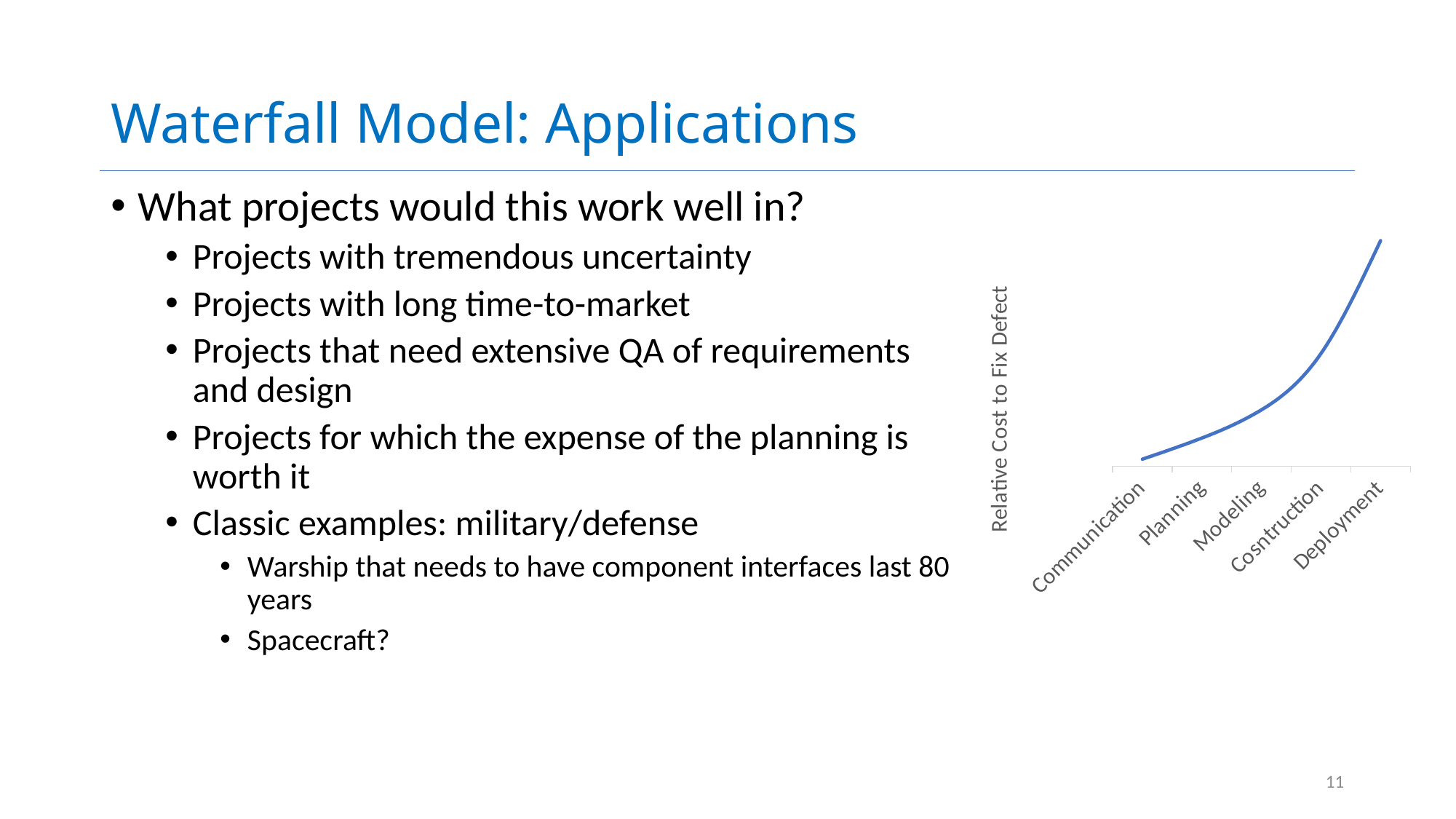
Which has a higher relative cost to fix a defect, Planning or Construction? Cosntruction Which category has the lowest relative cost to fix a defect? Communication Which category comes immediately after Modeling on the x axis? Cosntruction What kind of chart is shown on the slide? line chart What is the first category on the x axis of the chart? Communication How many categories are shown on the x axis of the chart? 5 Do the values rise or fall from Communication to Deployment? rise What is the label on the vertical axis of the chart? Relative Cost to Fix Defect Which category has the highest relative cost to fix a defect? Deployment Which has a lower relative cost to fix a defect, Modeling or Deployment? Modeling